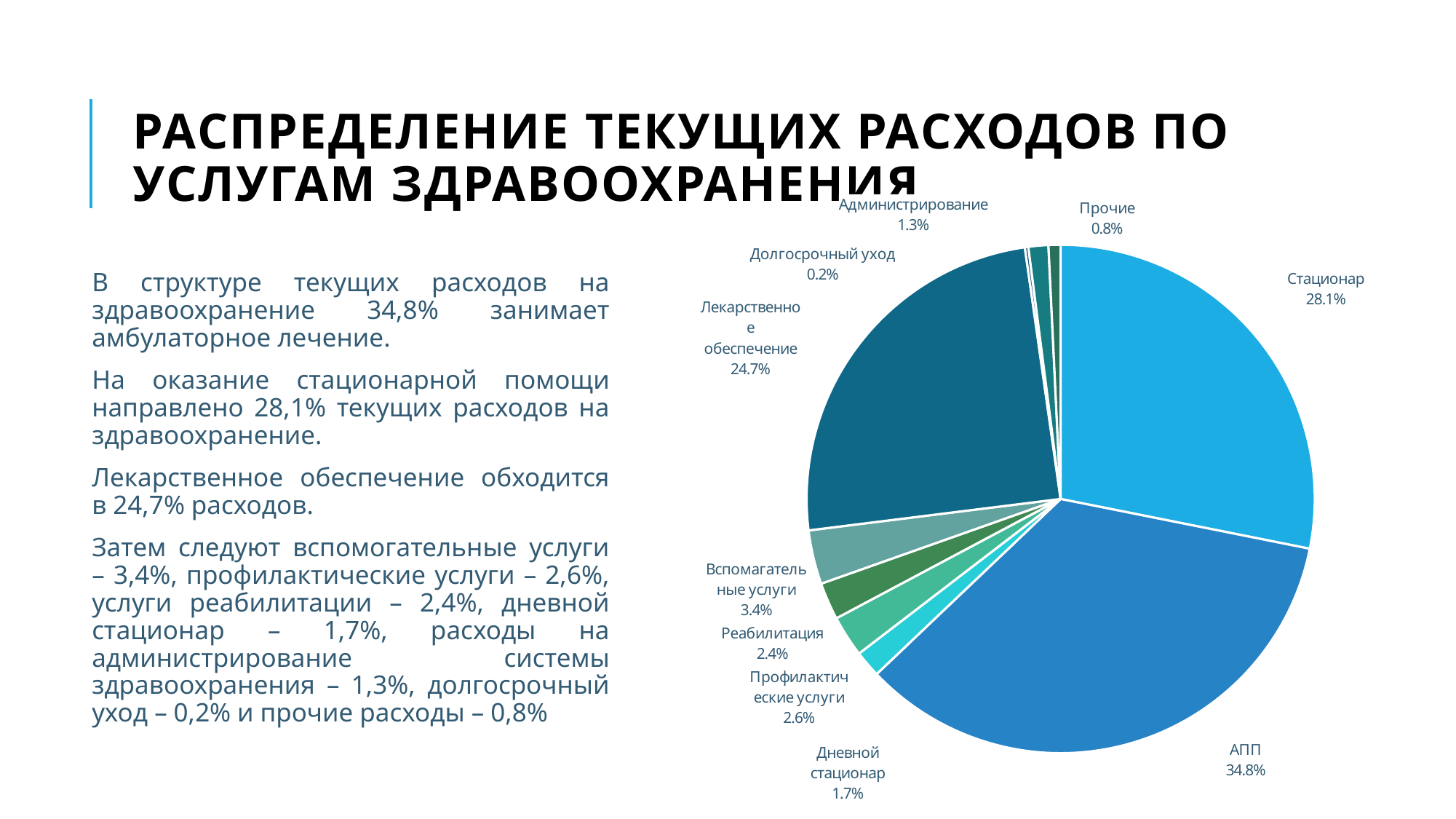
What is the value shown for Лекарственное обеспечение? 24.7% What share of current expenditure does АПП account for in the pie chart? 34.8% What is the value shown for Долгосрочный уход? 0.2% What kind of chart is shown on the slide? pie chart Which category has the largest slice of the pie? АПП Which category has the smallest slice of the pie? Долгосрочный уход What is the difference between the shares of АПП and Стационар? 6.7% What is the difference between the shares of Профилактические услуги and Администрирование? 1.3% Which is larger: the share for Вспомогательные услуги or for Реабилитация? Вспомогательные услуги What is the value shown for Дневной стационар? 1.7% What is the value shown for Прочие? 0.8% How many categories are shown in the pie chart? 10